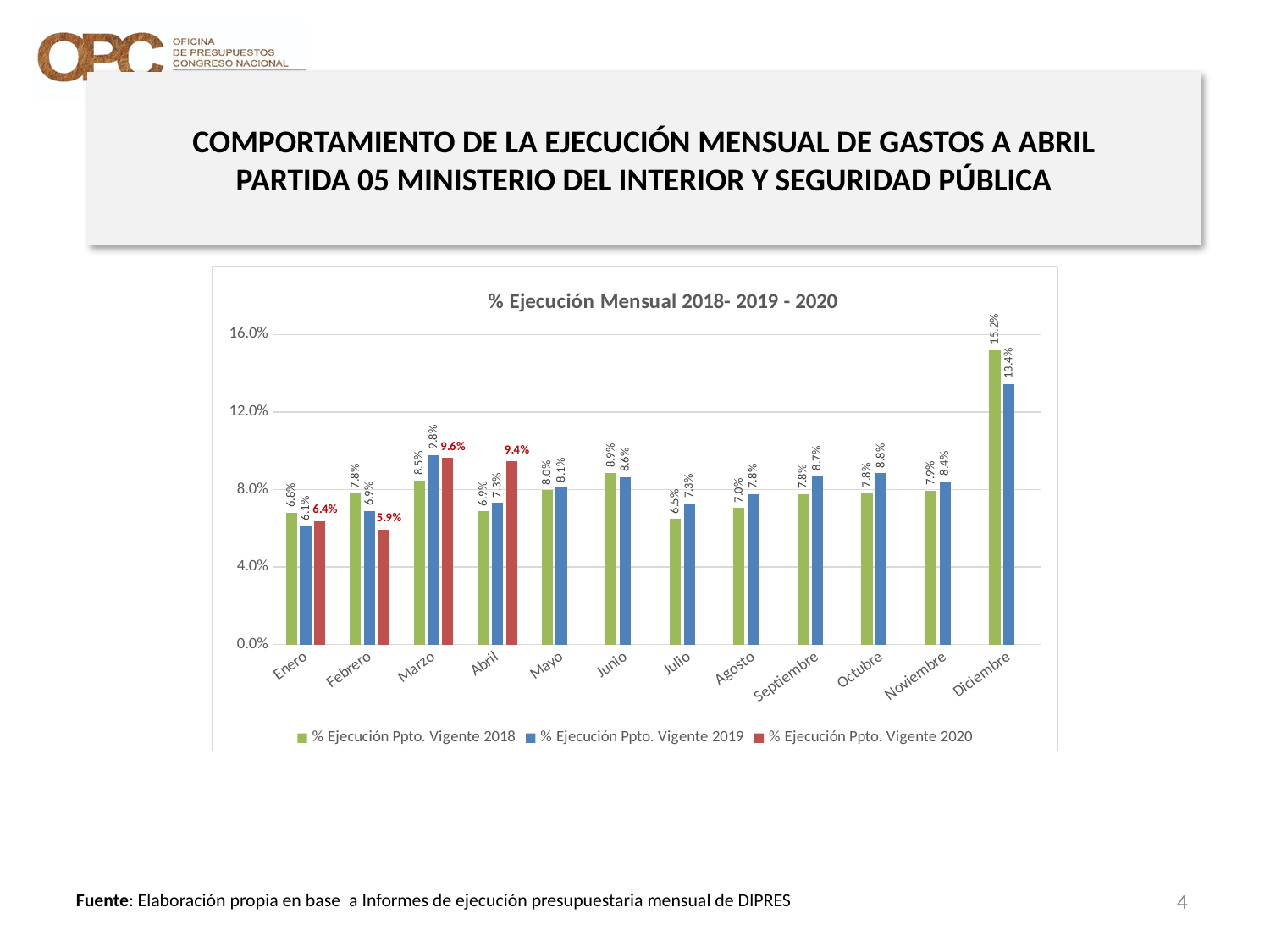
Which is larger in Enero: the 2019 value or the 2020 value? 2020 value (6.4%) How many series does the legend list? 3 Which month has the highest value for % Ejecución Ppto. Vigente 2019? Diciembre What is the value for % Ejecución Ppto. Vigente 2020 in Abril? 9.4% What is the value for % Ejecución Ppto. Vigente 2020 in Febrero? 5.9% Is the value for % Ejecución Ppto. Vigente 2019 in Diciembre greater or less than 12.0%? greater What is the value for % Ejecución Ppto. Vigente 2018 in Diciembre? 15.2% How many months are shown on the x axis? 12 What is the difference between the 2018 and 2019 values in Diciembre? 1.8% Which month has the lowest value for % Ejecución Ppto. Vigente 2018? Julio What is the value for % Ejecución Ppto. Vigente 2019 in Marzo? 9.8% What kind of chart is shown on the slide? Bar chart